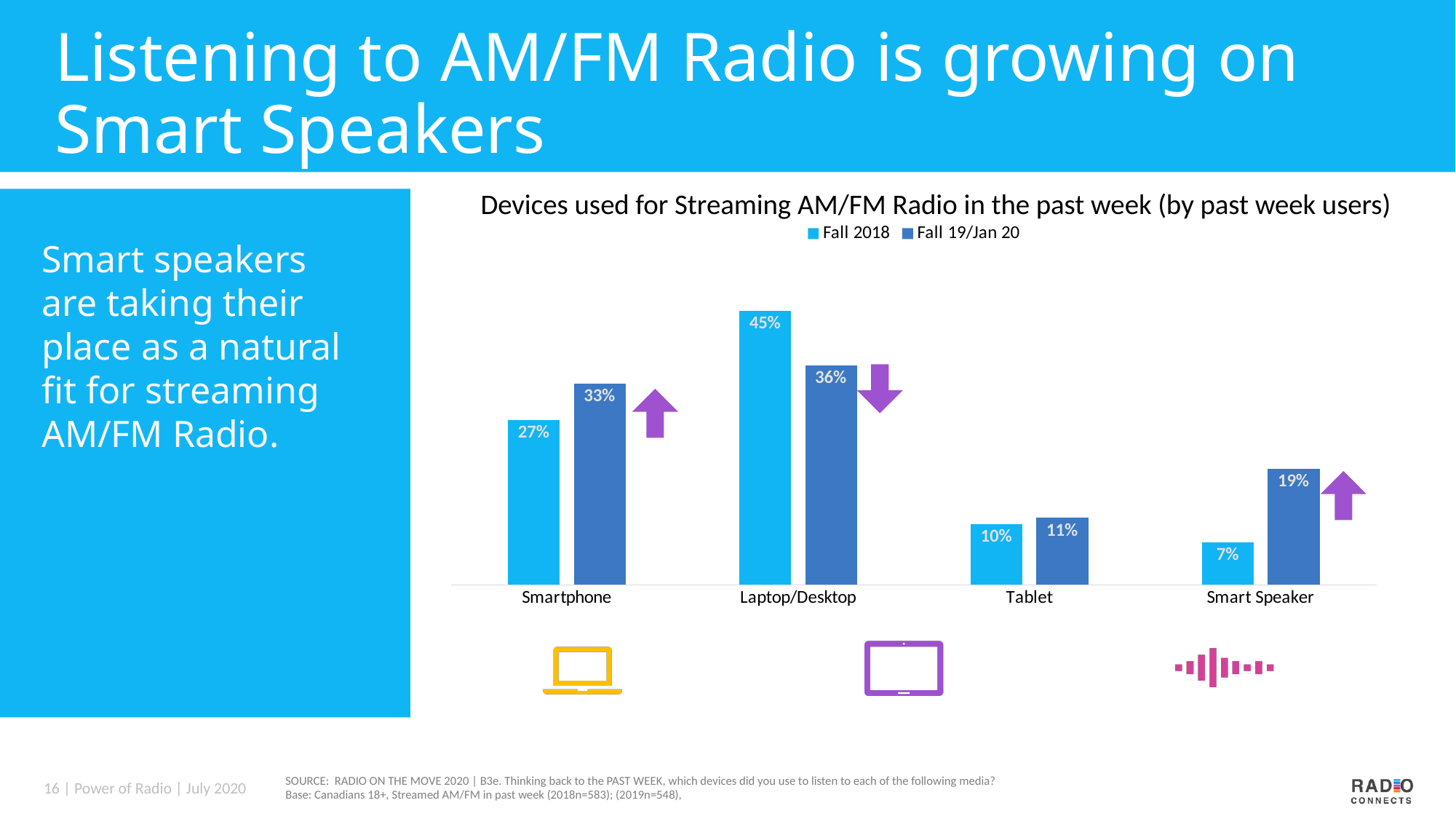
What is the Fall 19/Jan 20 value for Laptop/Desktop? 36% What is the difference between the Fall 2018 and Fall 19/Jan 20 values for Laptop/Desktop? 9% Which device has the lowest Fall 2018 value? Smart Speaker What is the difference between the Fall 2018 and Fall 19/Jan 20 values for Smart Speaker? 12% Which is larger for Smartphone: the Fall 2018 value or the Fall 19/Jan 20 value? Fall 19/Jan 20 What is the Fall 19/Jan 20 value for Smart Speaker? 19% Which device has the highest Fall 2018 value? Laptop/Desktop How many series does the legend list? 2 What is the title of the chart? Devices used for Streaming AM/FM Radio in the past week (by past week users) What kind of chart is shown on the slide? Bar chart What is the Fall 2018 value for Smartphone? 27% How many device categories are shown on the x axis? 4